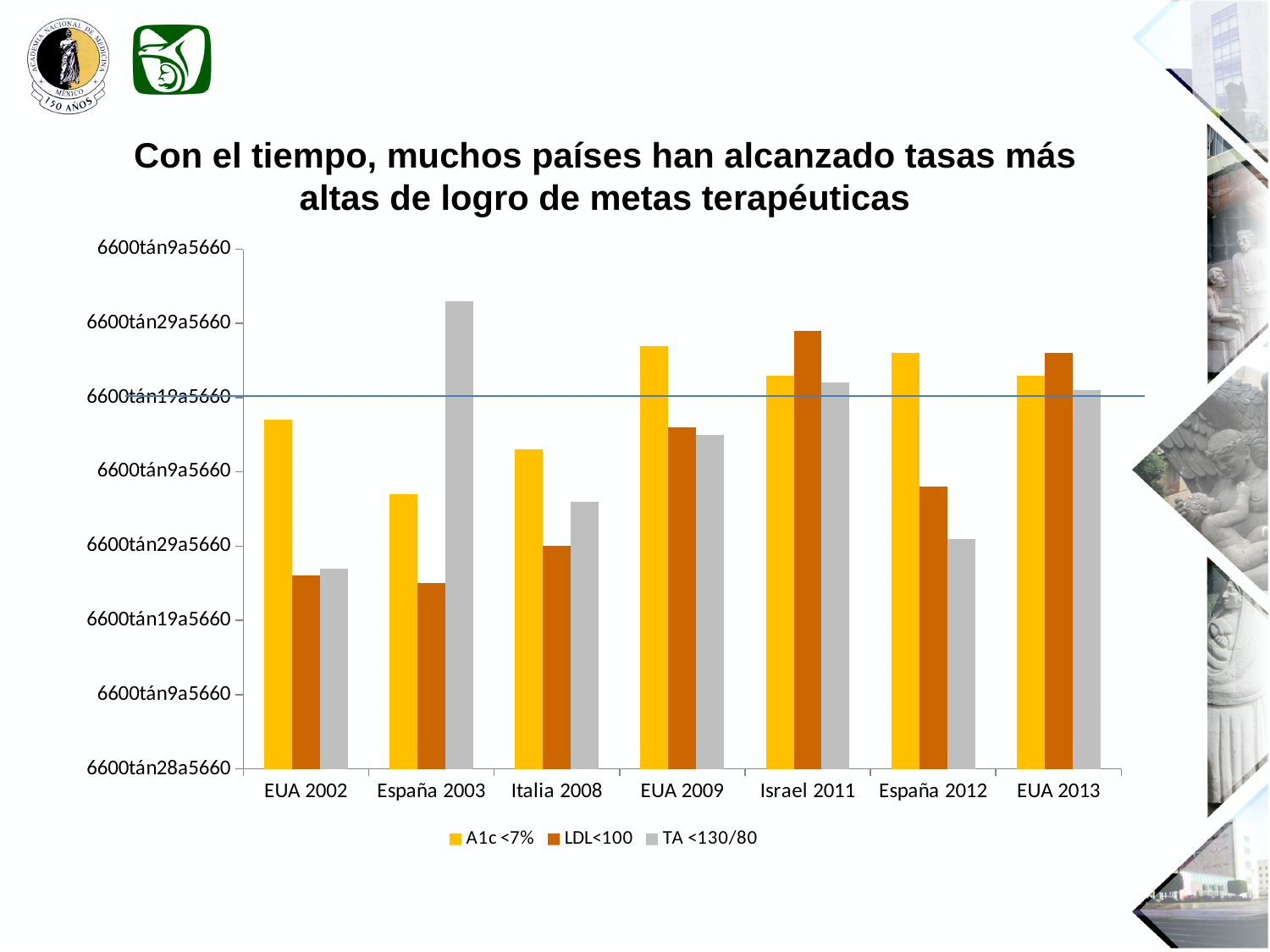
How many series does the legend list? 3 Which category has the highest LDL<100 bar? Israel 2011 Which category has the lowest A1c <7% bar? España 2003 Which series has the tallest bar in the whole chart? TA <130/80 (España 2003) How many categories (country-year groups) are shown on the x axis? 7 For EUA 2002, which series has the highest bar? A1c <7% Is the A1c <7% bar larger for EUA 2002 or for EUA 2009? EUA 2009 Which series has the shortest bar in the whole chart? LDL<100 (España 2003) What are the three series named in the legend? A1c <7%, LDL<100, TA <130/80 What kind of chart is shown on the slide? Bar chart Is the LDL<100 bar larger for Israel 2011 or for España 2012? Israel 2011